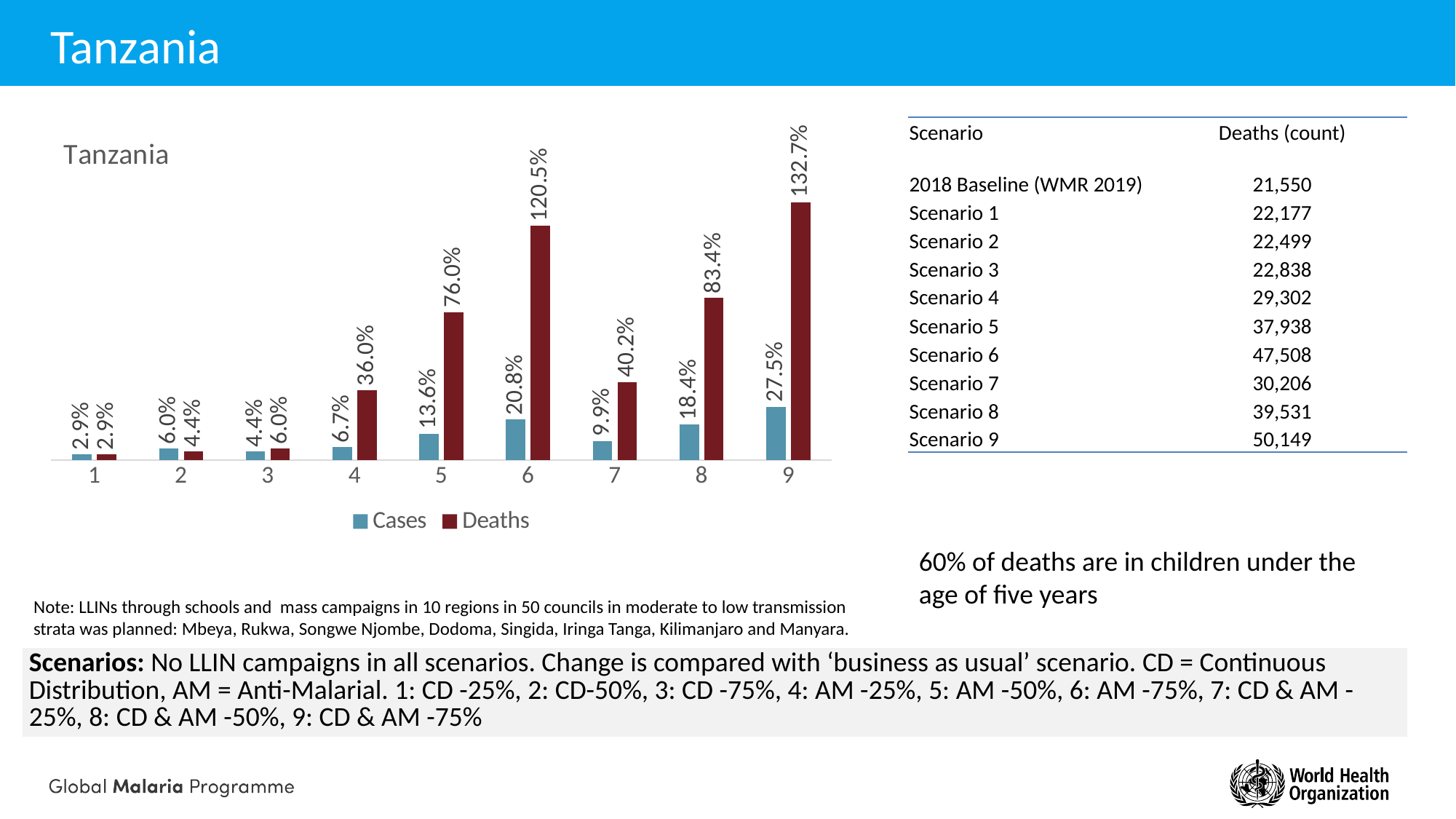
What colour are the Deaths bars in the chart? Dark red How many scenarios are shown on the x axis of the chart? 9 Which is larger for scenario 2, Cases or Deaths? Cases How many series does the chart legend list? 2 What is the Cases value for scenario 9? 27.5% Which scenario has the highest Deaths value? 9 What is the difference between the Deaths value and the Cases value for scenario 8? 65.0% Which scenario has the lowest Cases value? 1 What kind of chart is shown on the slide? Bar chart What is the difference in Deaths between scenario 9 and scenario 6? 12.2% What is the Cases value for scenario 5? 13.6% What is the Deaths value for scenario 6? 120.5%